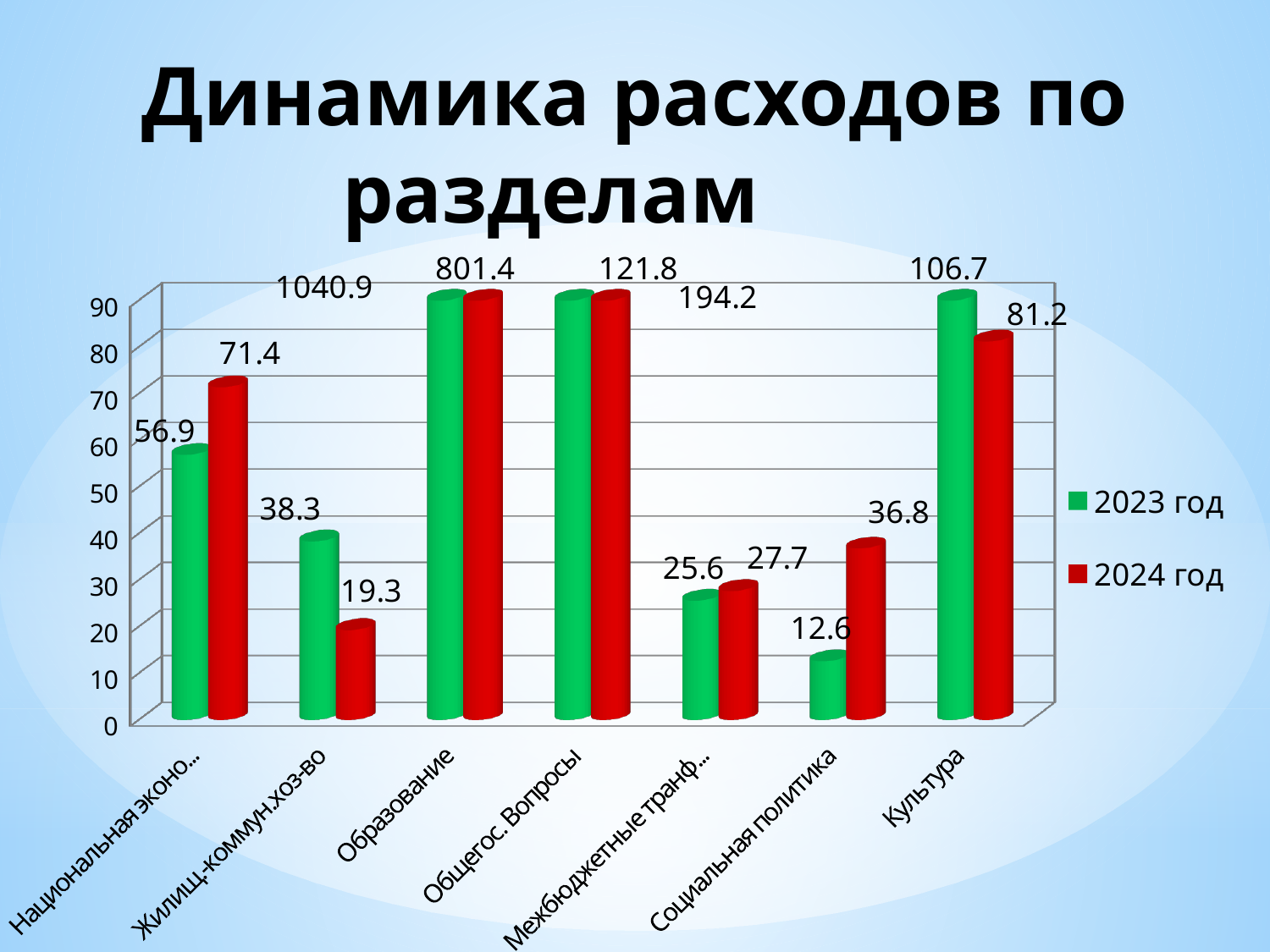
What is the value for Жилищ.-коммун.хоз-во in the 2024 год series? 19.3 What is the value for Культура in the 2024 год series? 81.2 Which category has the lowest value in the 2023 год series? Социальная политика How many categories are shown on the x axis of the chart? 7 What is the value for Образование in the 2023 год series? 1040.9 How many series does the legend list? 2 For Общегос. Вопросы, which series has the larger value, 2023 год or 2024 год? 2024 год What is the difference between the 2023 год and 2024 год values for Культура? 25.5 What is the difference between the 2024 год and 2023 год values for Социальная политика? 24.2 Which category has the highest value in the 2023 год series? Образование What kind of chart is shown on the slide? Bar chart What is the value for Социальная политика in the 2023 год series? 12.6